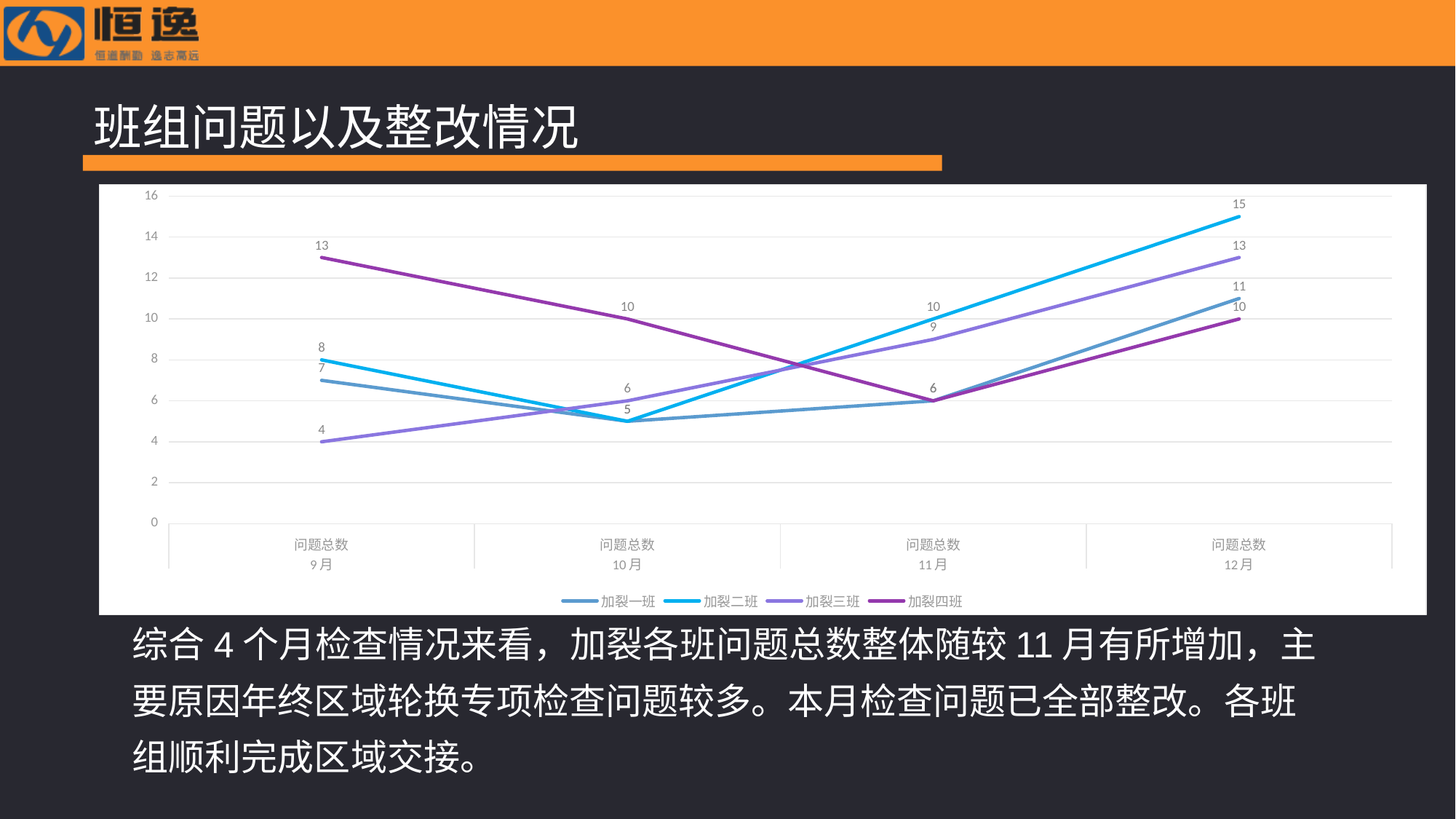
How many series does the legend list? 4 What kind of chart is shown on the slide? Line chart What is the value for 加裂二班 in 12月? 15 Which series has the highest value in 12月? 加裂二班 What is the difference between the 加裂二班 values in 12月 and 9月? 7 What is the value for 加裂三班 in 9月? 4 What is the value for 加裂一班 in 12月? 11 What is the value for 加裂三班 in 11月? 9 What is the value for 加裂四班 in 9月? 13 Does the value for 加裂三班 rise or fall from 9月 to 12月? Rise Which series has the lowest value in 9月? 加裂三班 For 加裂四班, which is larger: the value in 9月 or the value in 12月? 9月